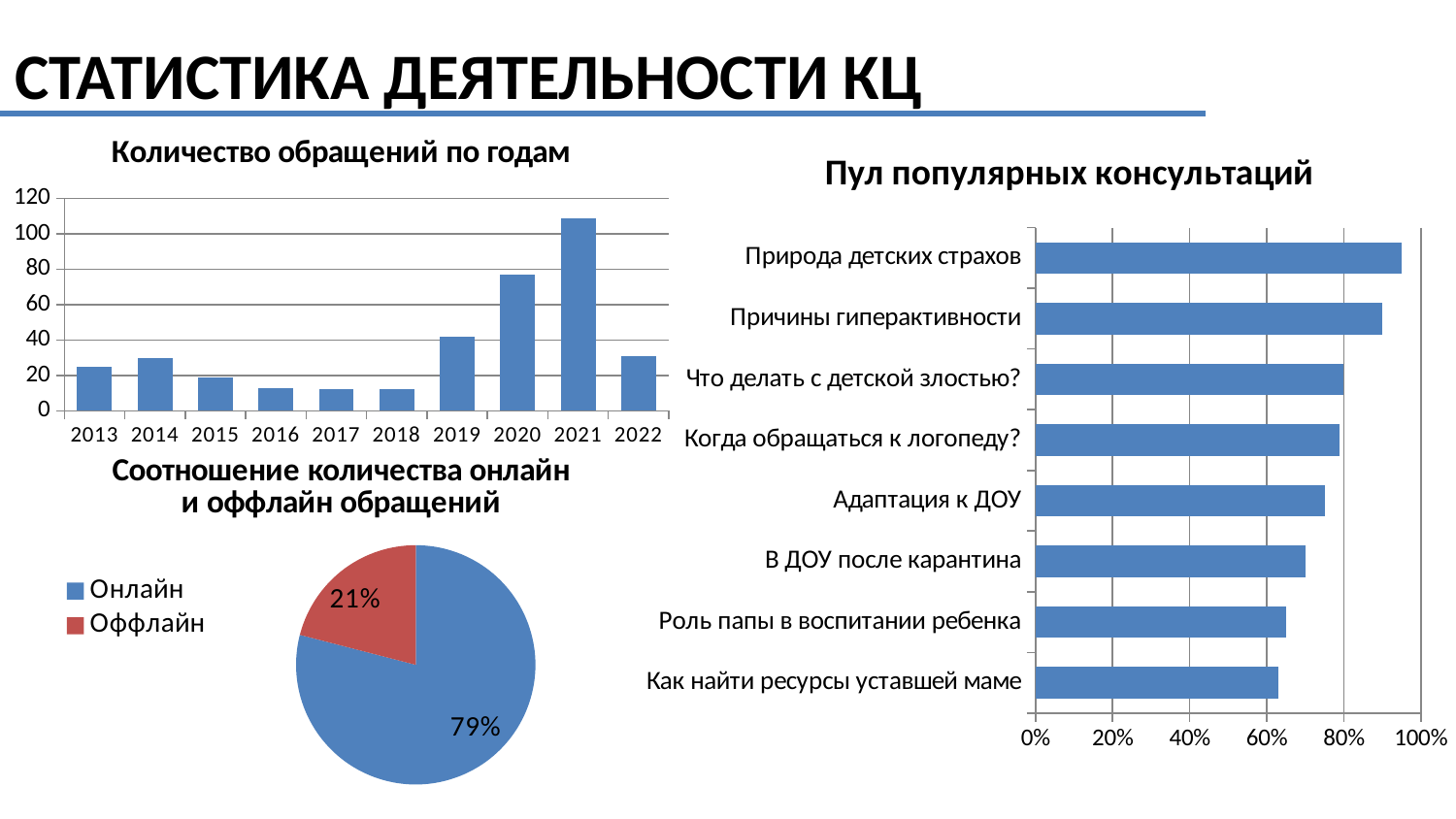
In the chart 'Количество обращений по годам', which is larger, the value for 2020 or the value for 2022? 2020 In the chart 'Количество обращений по годам', is the value for 2020 greater or less than 60? greater In the pie chart 'Соотношение количества онлайн и оффлайн обращений', what is the difference between the Онлайн and Оффлайн shares? 58% In the chart 'Количество обращений по годам', is the value for 2021 greater or less than 100? greater In the pie chart 'Соотношение количества онлайн и оффлайн обращений', what share is Онлайн? 79% In the chart 'Количество обращений по годам', how many years are shown on the x axis? 10 In the chart 'Пул популярных консультаций', which category has the highest value? Природа детских страхов In the pie chart 'Соотношение количества онлайн и оффлайн обращений', what is the value for Оффлайн? 21% In the chart 'Пул популярных консультаций', is the value for 'Адаптация к ДОУ' greater or less than 80%? less What type of chart is 'Пул популярных консультаций'? bar chart In the chart 'Количество обращений по годам', which year has the highest value? 2021